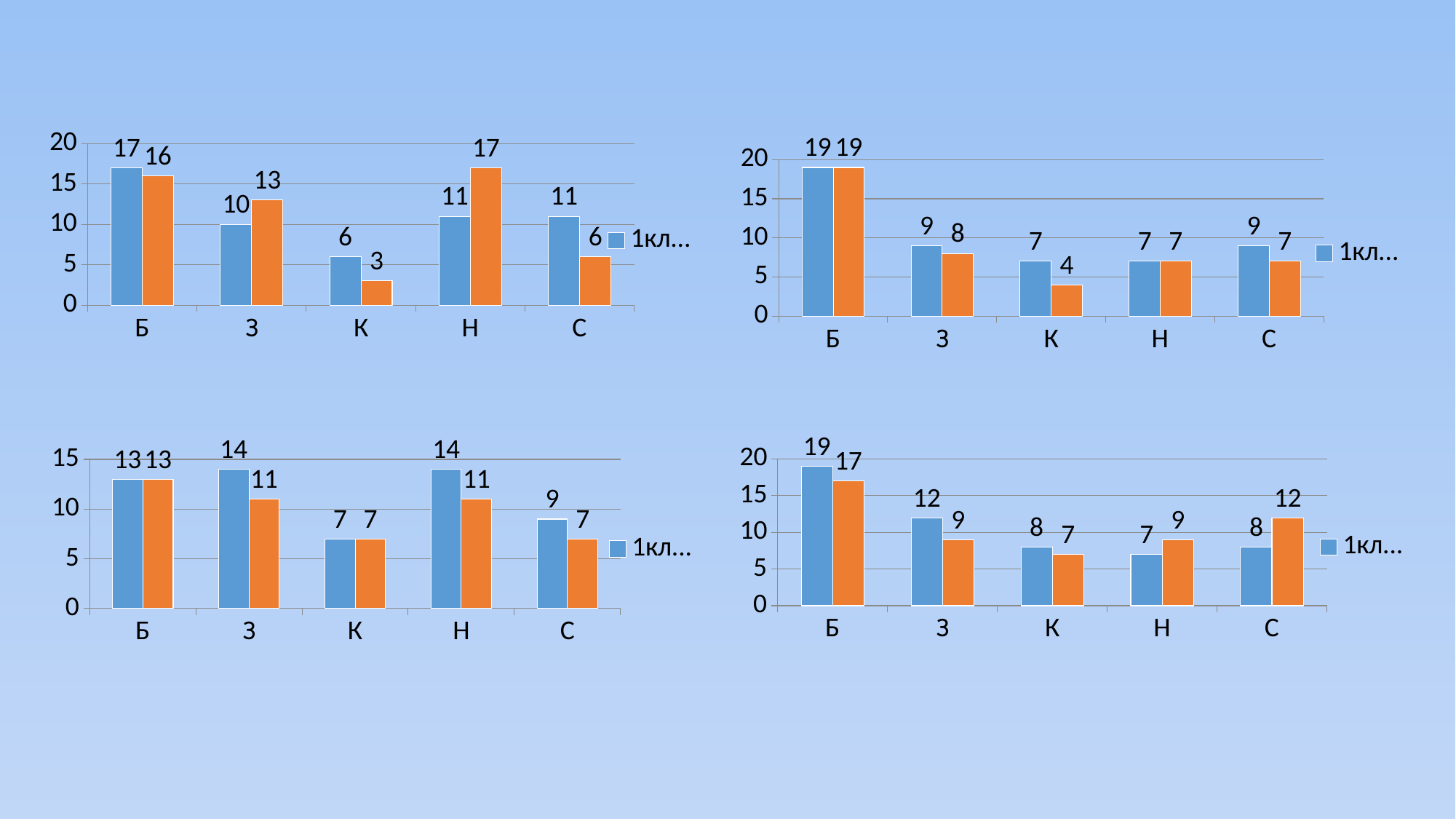
In the top-left chart, what is the value of the blue bar for category Б? 17 In the top-right chart, is the blue bar for category З larger or smaller than the orange bar for З? larger In the top-left chart, what is the value of the orange bar for category Н? 17 In the top-left chart, what is the difference between the blue and orange bars for category С? 5 In the bottom-right chart, what is the value of the orange bar for category С? 12 In the bottom-right chart, is the orange bar for category Н larger or smaller than the blue bar for Н? larger How many categories are shown on the x axis of the bottom-right chart? 5 In the top-left chart, which category has the lowest orange bar? К In the bottom-left chart, what is the value of the orange bar for category З? 11 In the top-right chart, which category has the highest blue bar? Б In the top-right chart, what is the value of the orange bar for category К? 4 In the bottom-left chart, what is the difference between the blue and orange bars for category Н? 3